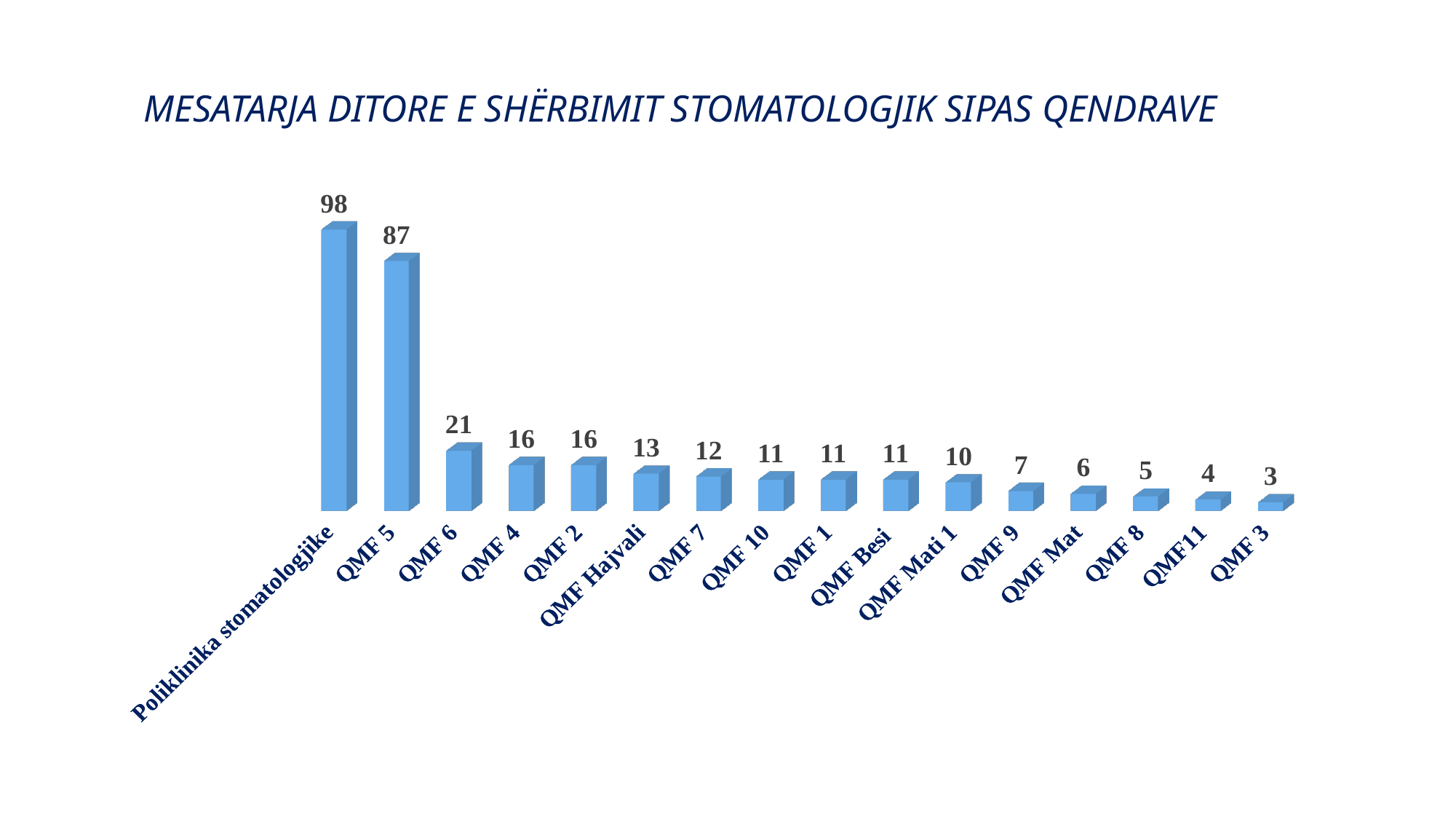
What is the difference between the values for QMF 6 and QMF 4? 5 What is the value for QMF Mati 1? 10 Which is larger, the value for QMF 7 or the value for QMF 9? QMF 7 Which category has the lowest value? QMF 3 Which category has the highest value? Poliklinika stomatologjike What kind of chart is shown on the slide? Bar chart How many categories are shown in the chart? 16 What is the value for Poliklinika stomatologjike? 98 What is the value for QMF 6? 21 What is the difference between the values for Poliklinika stomatologjike and QMF 5? 11 What is the title of the chart? MESATARJA DITORE E SHËRBIMIT STOMATOLOGJIK SIPAS QENDRAVE What is the value for QMF Hajvali? 13